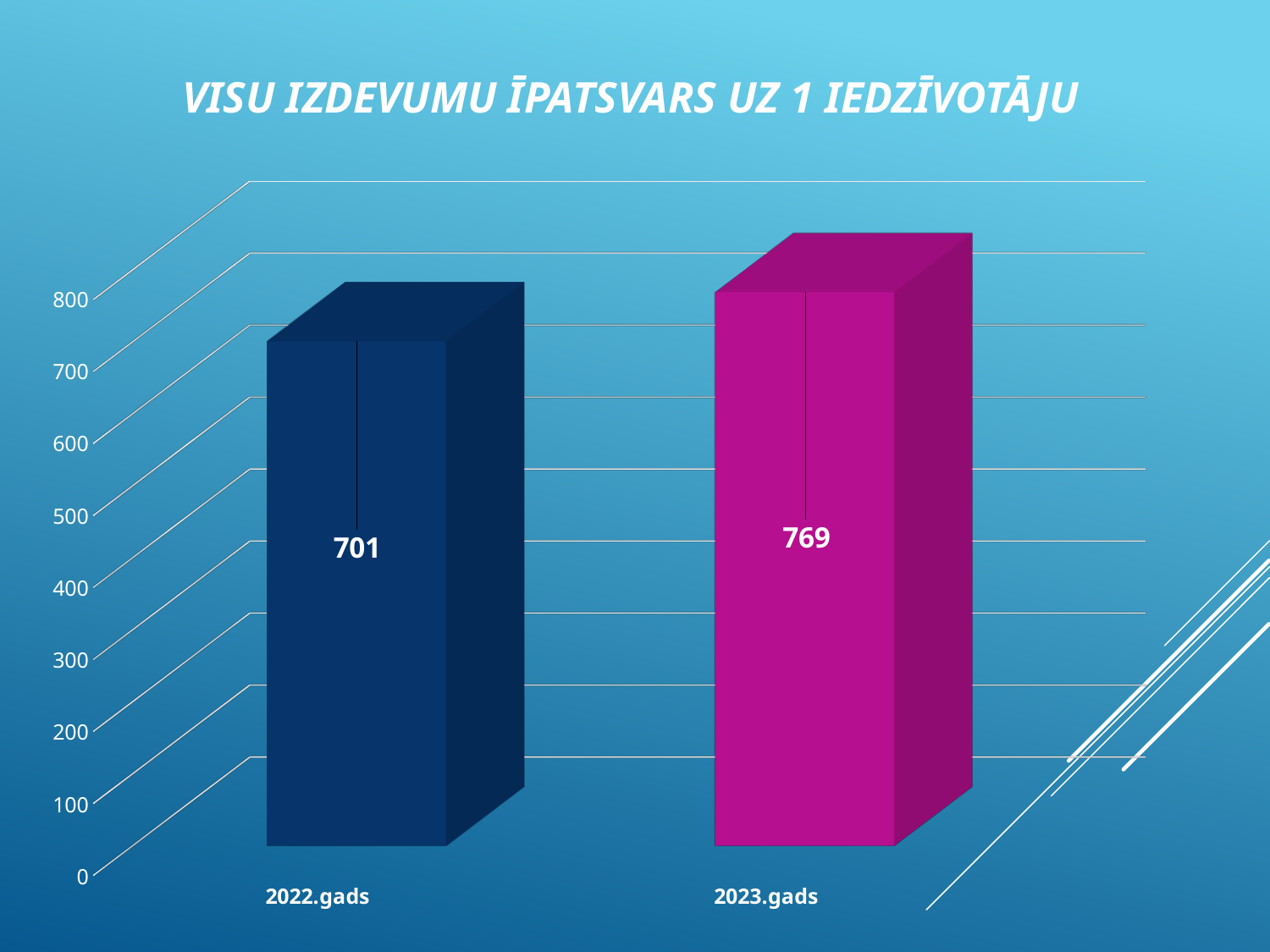
How many categories are shown on the x axis? 2 Which year has the higher value? 2023.gads Is the value for 2022.gads or 2023.gads larger? 2023.gads What is the value for 2022.gads? 701 Do the values rise or fall from 2022.gads to 2023.gads? rise What colour is the bar for 2023.gads? magenta What is the value for 2023.gads? 769 Is the value for 2022.gads greater or less than 800? less What is the difference between the values for 2023.gads and 2022.gads? 68 What kind of chart is shown on the slide? bar chart What is the title of the chart? VISU IZDEVUMU ĪPATSVARS UZ 1 IEDZĪVOTĀJU Which year has the lower value? 2022.gads